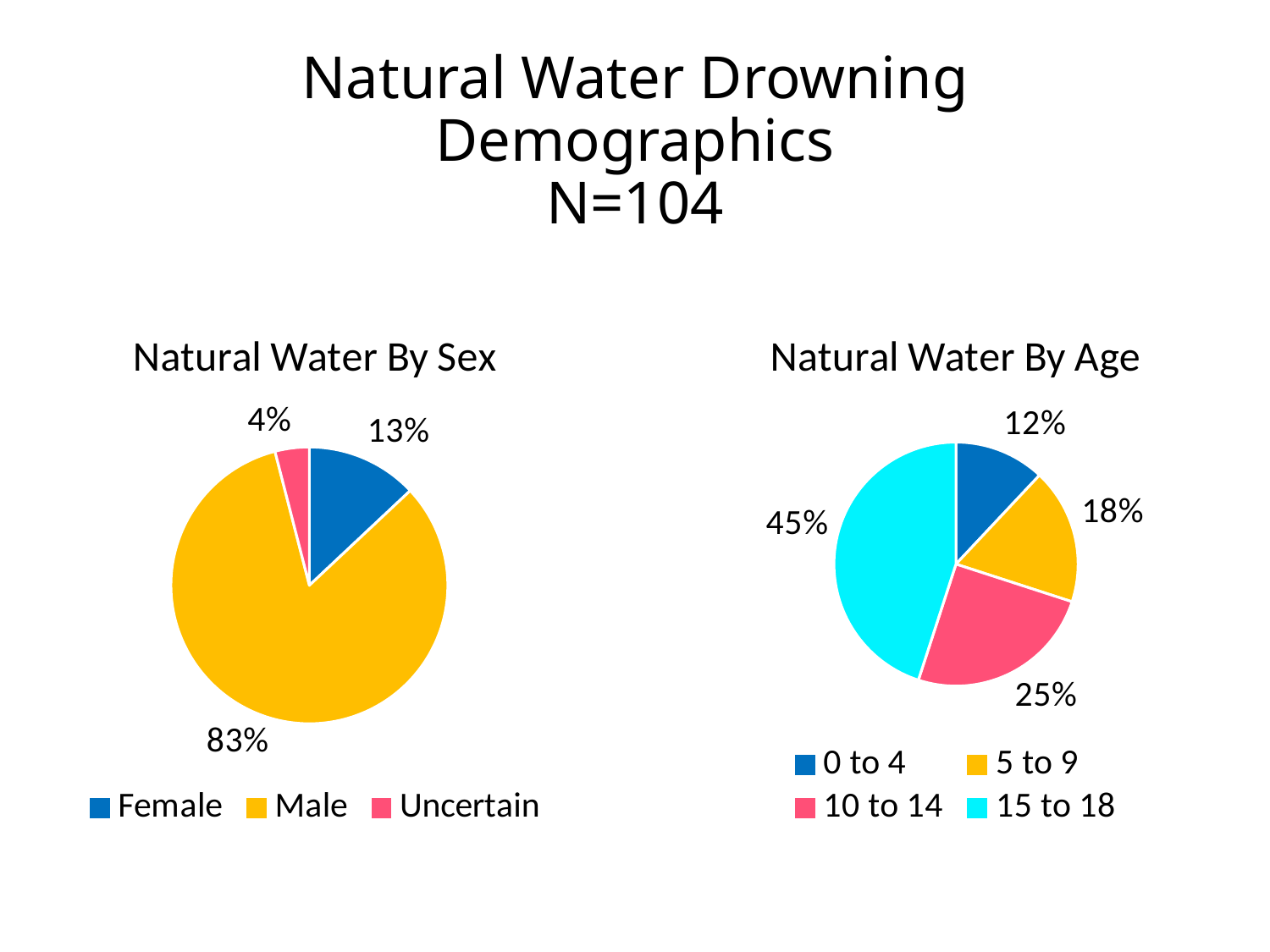
In the 'Natural Water By Sex' chart, which category has the largest slice? Male What kind of chart is 'Natural Water By Sex'? Pie chart In the 'Natural Water By Age' chart, what share is the 10 to 14 group? 25% In the 'Natural Water By Age' chart, which is larger, the 5 to 9 group or the 10 to 14 group? 10 to 14 In the 'Natural Water By Sex' chart, what is the difference between the Male and Female shares? 70% In the 'Natural Water By Sex' chart, what share is Female? 13% In the 'Natural Water By Sex' chart, what share is Male? 83% In the 'Natural Water By Age' chart, which age group has the smallest slice? 0 to 4 In the 'Natural Water By Age' chart, what share is the 15 to 18 group? 45% How many categories does the legend of the 'Natural Water By Age' chart list? 4 In the 'Natural Water By Sex' chart, which category has the smallest slice? Uncertain In the 'Natural Water By Sex' chart, what share is Uncertain? 4%